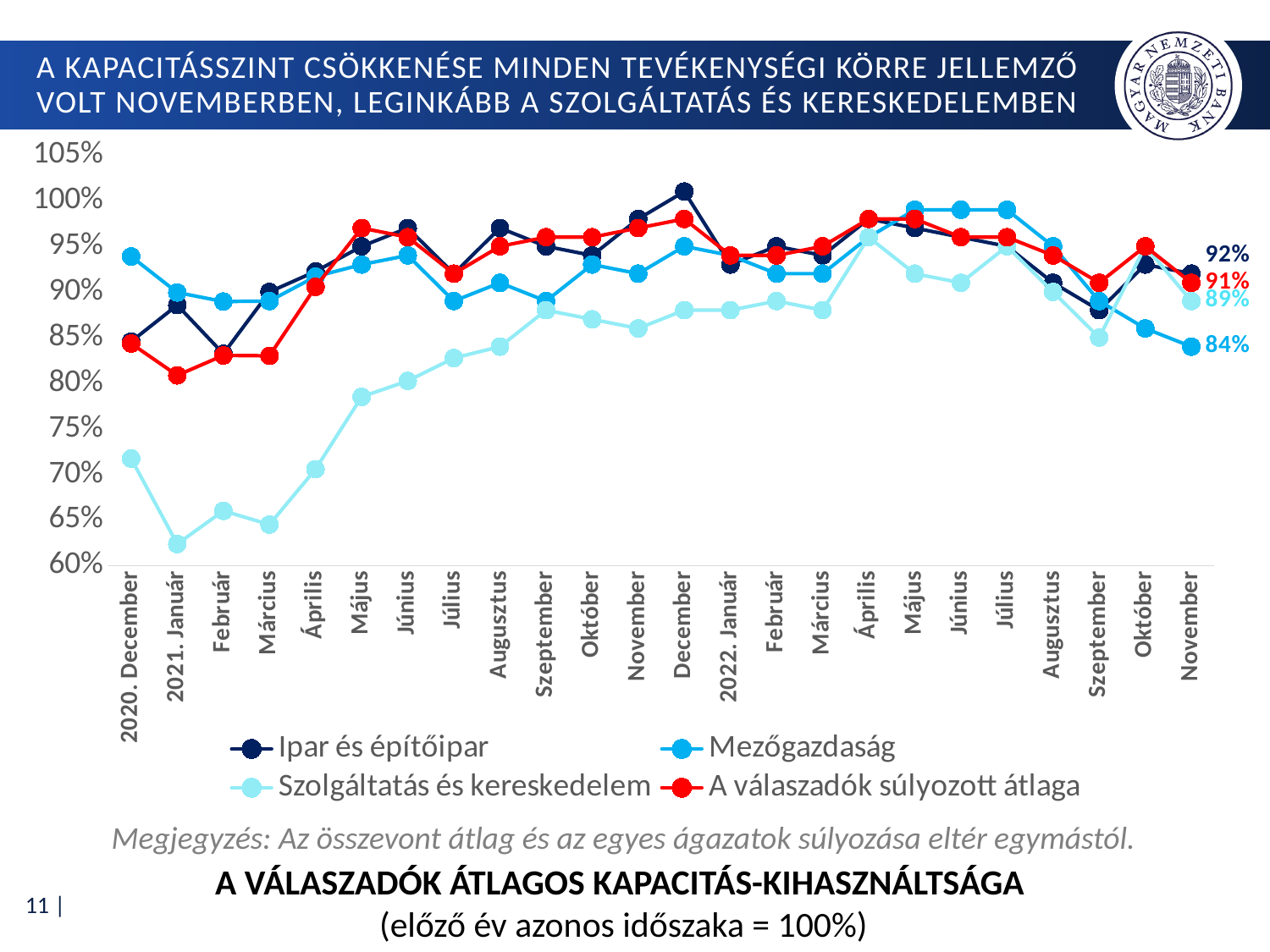
Which series has the lowest value in November 2022? Mezőgazdaság Is the value for Szolgáltatás és kereskedelem in 2021 Január greater or less than 65%? less What is the value for A válaszadók súlyozott átlaga in November 2022? 91% Does the Szolgáltatás és kereskedelem line rise or fall between 2021 Január and 2021 Szeptember? rise Which is larger in November 2022: Ipar és építőipar or Szolgáltatás és kereskedelem? Ipar és építőipar What kind of chart is shown on the slide? Line chart How many time points are shown on the x axis? 24 What is the value for Szolgáltatás és kereskedelem in November 2022? 89% What is the value for Mezőgazdaság in November 2022? 84% How many series does the legend list? 4 What is the difference between Ipar és építőipar and Mezőgazdaság in November 2022? 8 percentage points What is the value for Ipar és építőipar in November 2022? 92%